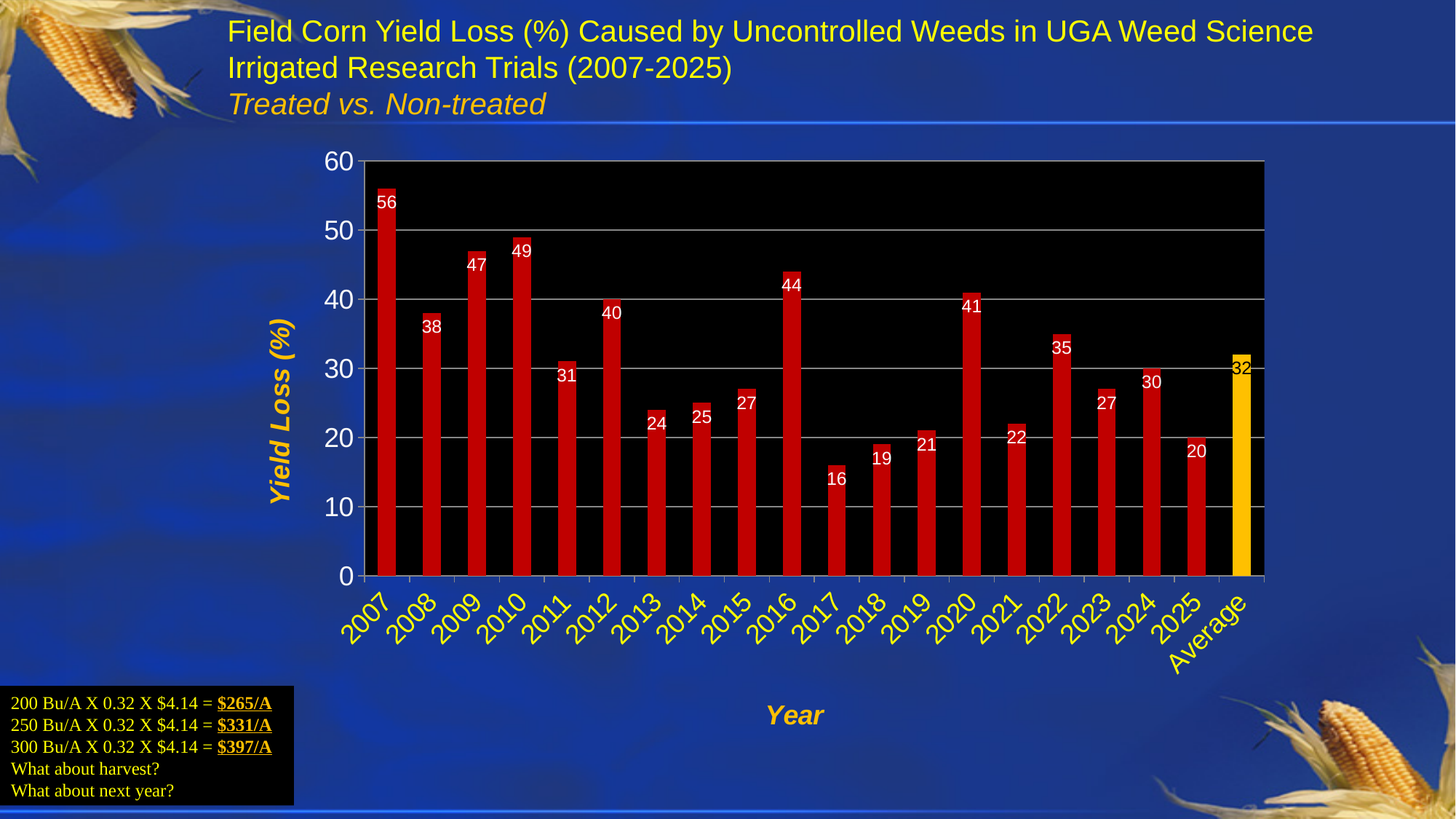
What is the label of the y axis? Yield Loss (%) What is the difference between the yield loss in 2010 and in 2011? 18 How many bars are plotted in the chart, including the Average bar? 20 Which year has the highest yield loss? 2007 What colour is the Average bar? Yellow What kind of chart is shown on the slide? Bar chart What is the yield loss value for 2007? 56 What is the value of the Average bar? 32 Which year has the lowest yield loss? 2017 Is the value for 2022 greater or less than 30? greater Which year has a larger yield loss, 2016 or 2020? 2016 What is the yield loss value for 2017? 16